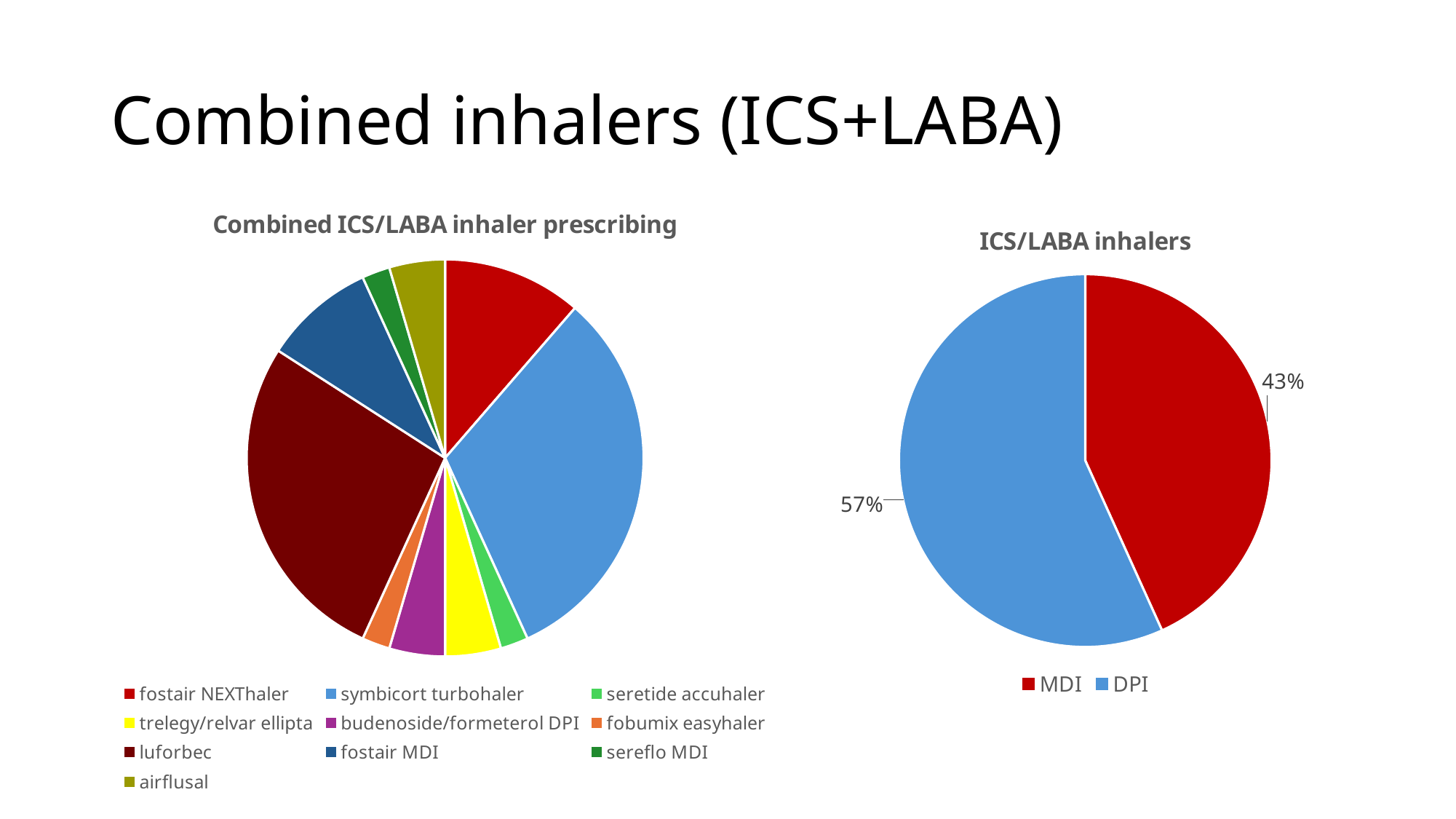
What are the two legend entries of the 'ICS/LABA inhalers' chart? MDI and DPI In the 'ICS/LABA inhalers' pie chart, what share does DPI have? 57% In the 'Combined ICS/LABA inhaler prescribing' chart, which slice is larger, symbicort turbohaler or fostair NEXThaler? symbicort turbohaler What is the title of the pie chart on the left of the slide? Combined ICS/LABA inhaler prescribing In the 'ICS/LABA inhalers' pie chart, what is the difference between the DPI share and the MDI share? 14% How many categories are shown in the 'Combined ICS/LABA inhaler prescribing' chart? 10 In the 'ICS/LABA inhalers' pie chart, what share does MDI have? 43% What kind of chart is the 'ICS/LABA inhalers' chart? Pie chart What kind of chart is the 'Combined ICS/LABA inhaler prescribing' chart? Pie chart In the 'ICS/LABA inhalers' pie chart, which slice is larger, MDI or DPI? DPI In the 'Combined ICS/LABA inhaler prescribing' chart, which slice is larger, luforbec or fostair MDI? luforbec How many slices does the 'ICS/LABA inhalers' pie chart have? 2